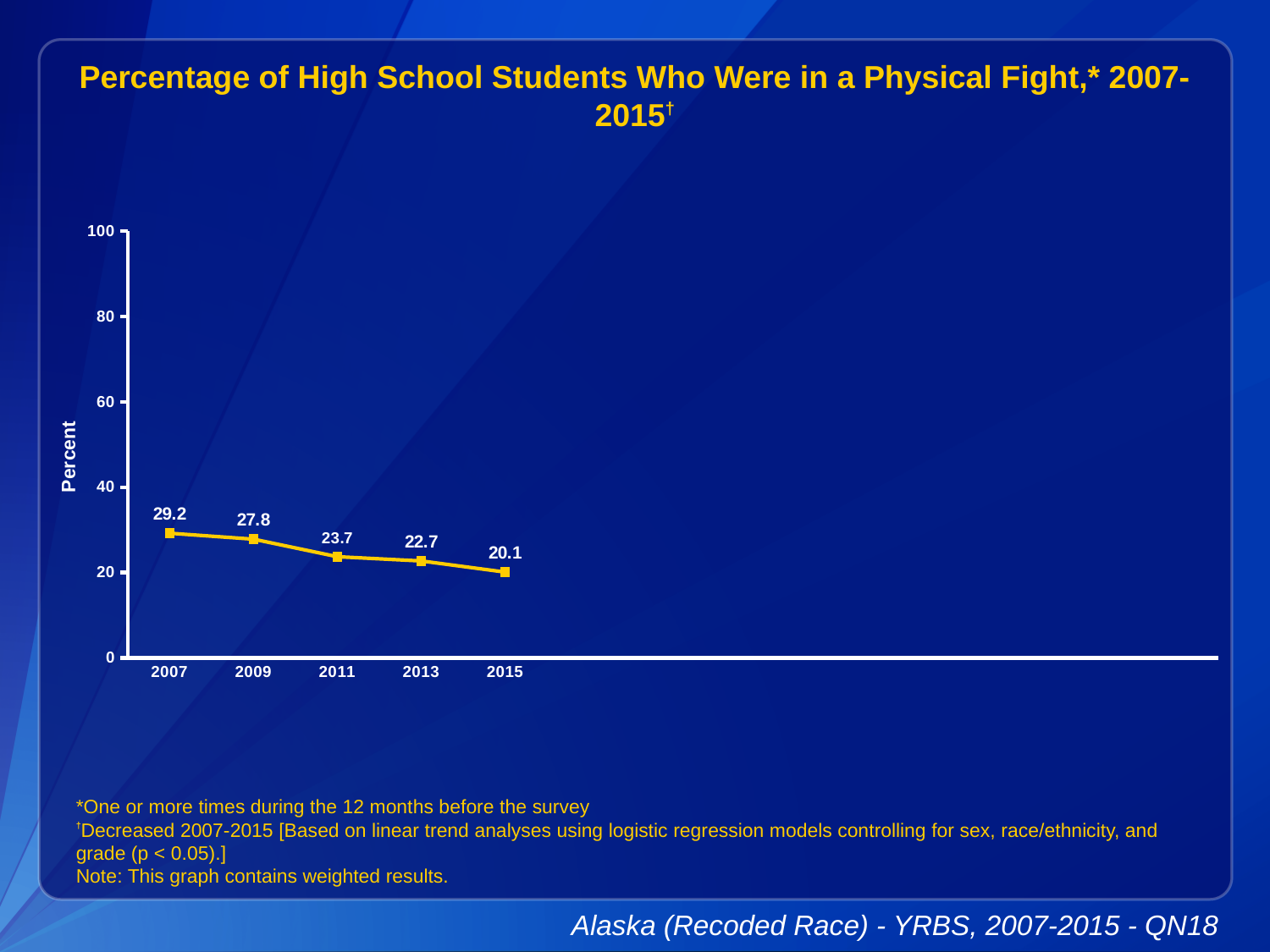
What is the value plotted for 2011? 23.7 Is the value for 2013 greater or less than 40? less How many years are plotted on the chart? 5 What is the difference between the 2009 and 2013 values? 5.1 Which year has the highest percentage of students who were in a physical fight? 2007 Which year has the lowest percentage of students who were in a physical fight? 2015 What percentage of high school students were in a physical fight in 2007? 29.2 Do the values rise or fall from 2007 to 2015? fall Which year has the larger value, 2009 or 2011? 2009 What kind of chart is shown on the slide? line chart By how many percentage points did the value fall from 2007 to 2015? 9.1 What is the value plotted for 2015? 20.1